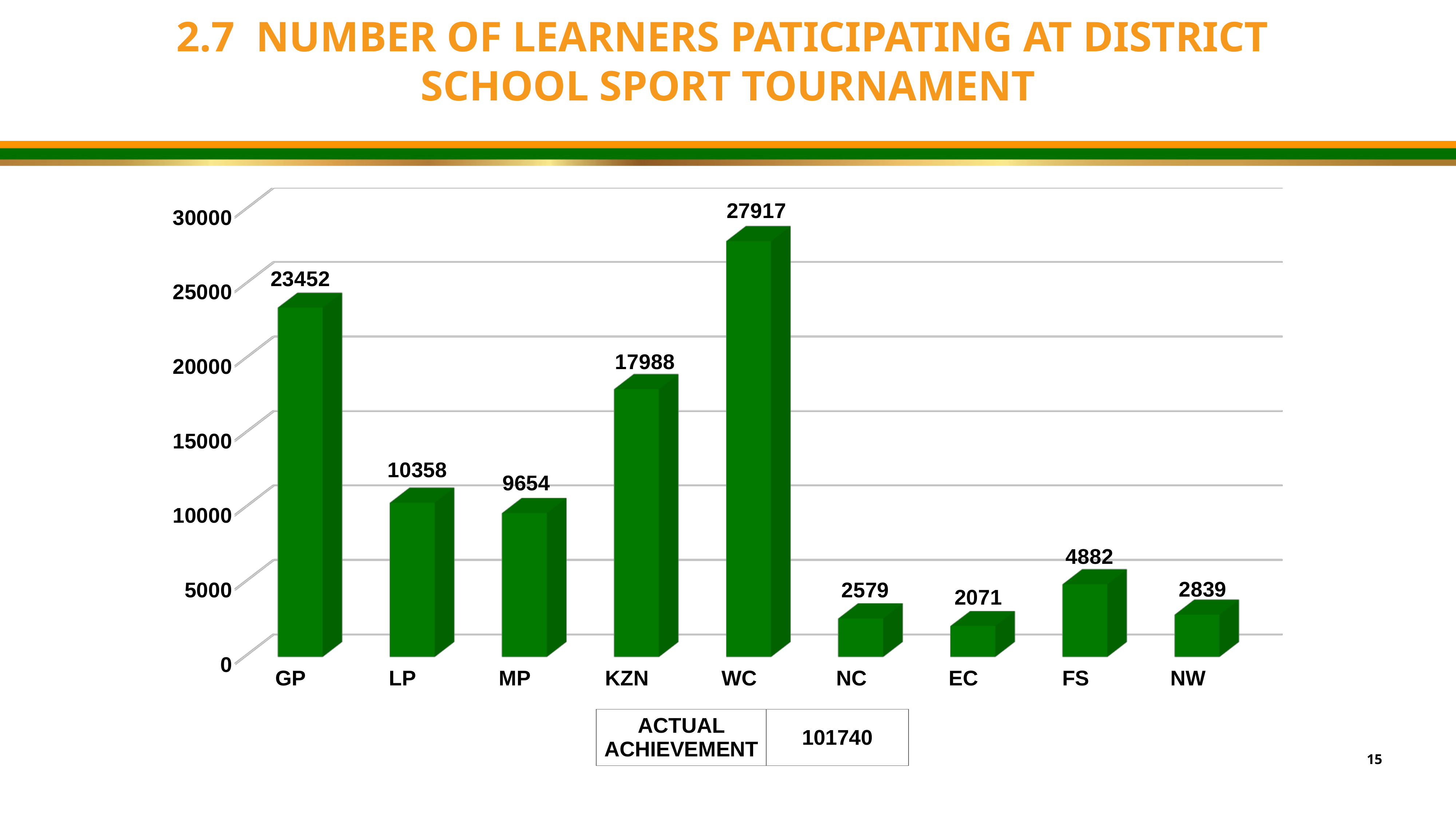
What is the difference between the values for WC and GP? 4465 Which has a larger value, NW or NC? NW How many provinces are shown on the x axis? 9 Which province has the lowest number of learners participating? EC What is the value shown for FS? 4882 What is the difference between the values for LP and MP? 704 What is the actual achievement total shown in the table below the chart? 101740 What kind of chart is shown on the slide? bar chart What is the number of learners participating for WC? 27917 What is the number of learners participating for KZN? 17988 Is the value for KZN greater or less than 15000? greater Which province has the highest number of learners participating? WC